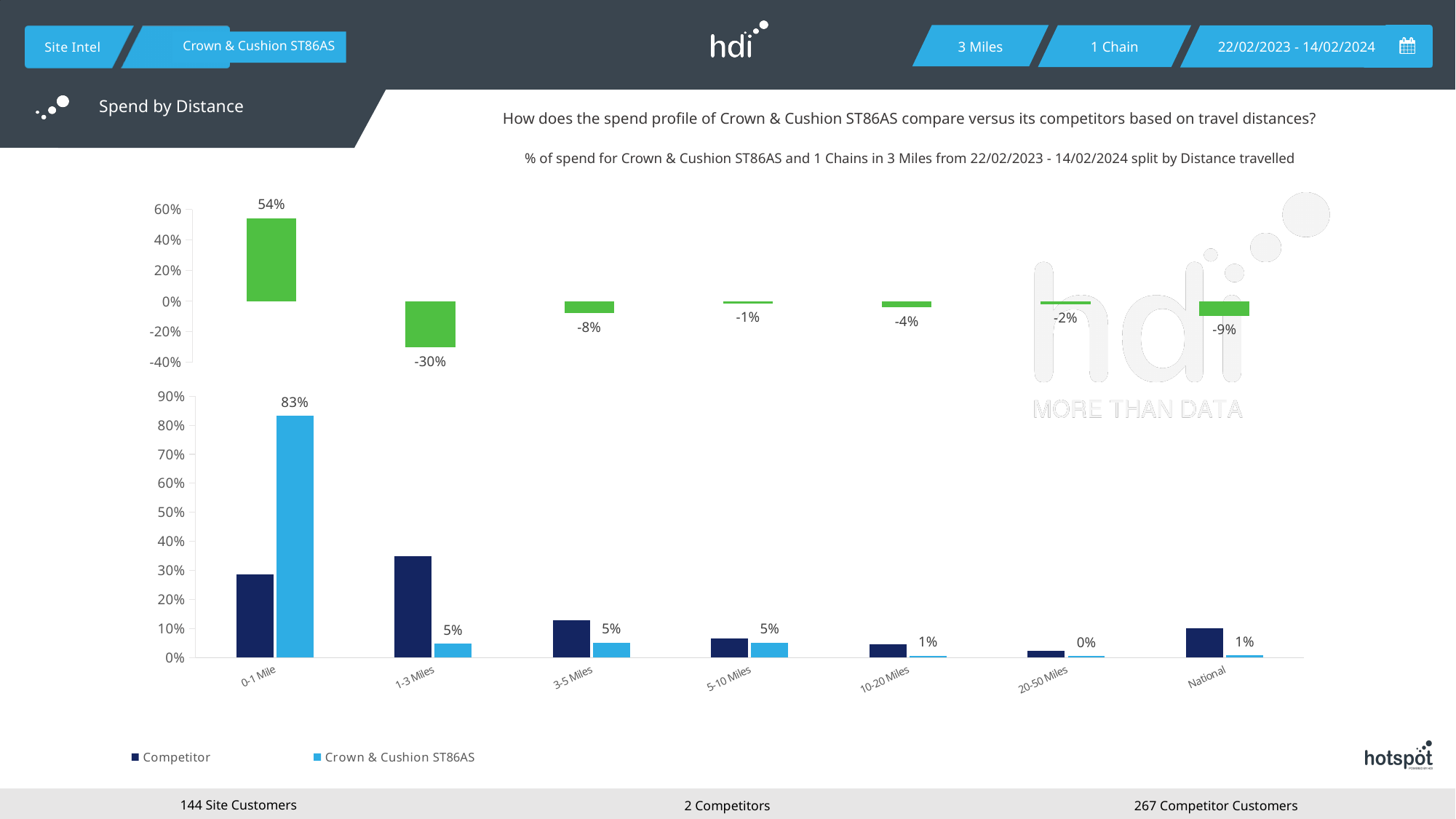
In the bottom chart, what is the value for Crown & Cushion ST86AS at 0-1 Mile? 83% In the bottom chart, what is the difference between the Crown & Cushion ST86AS values for 0-1 Mile and 1-3 Miles? 78% In the bottom chart, which is larger at 1-3 Miles: the Competitor bar or the Crown & Cushion ST86AS bar? Competitor In the bottom chart, is the Competitor value for 1-3 Miles greater or less than 30%? greater In the top chart, what is the value shown for 1-3 Miles? -30% How many series does the legend of the bottom chart list? 2 In the top chart, what is the value shown for National? -9% In the top chart, which distance band has the highest value? 0-1 Mile In the top chart, which distance band has the lowest value? 1-3 Miles How many distance categories are shown on the x axis of the bottom chart? 7 What type of chart is the bottom chart? Bar chart